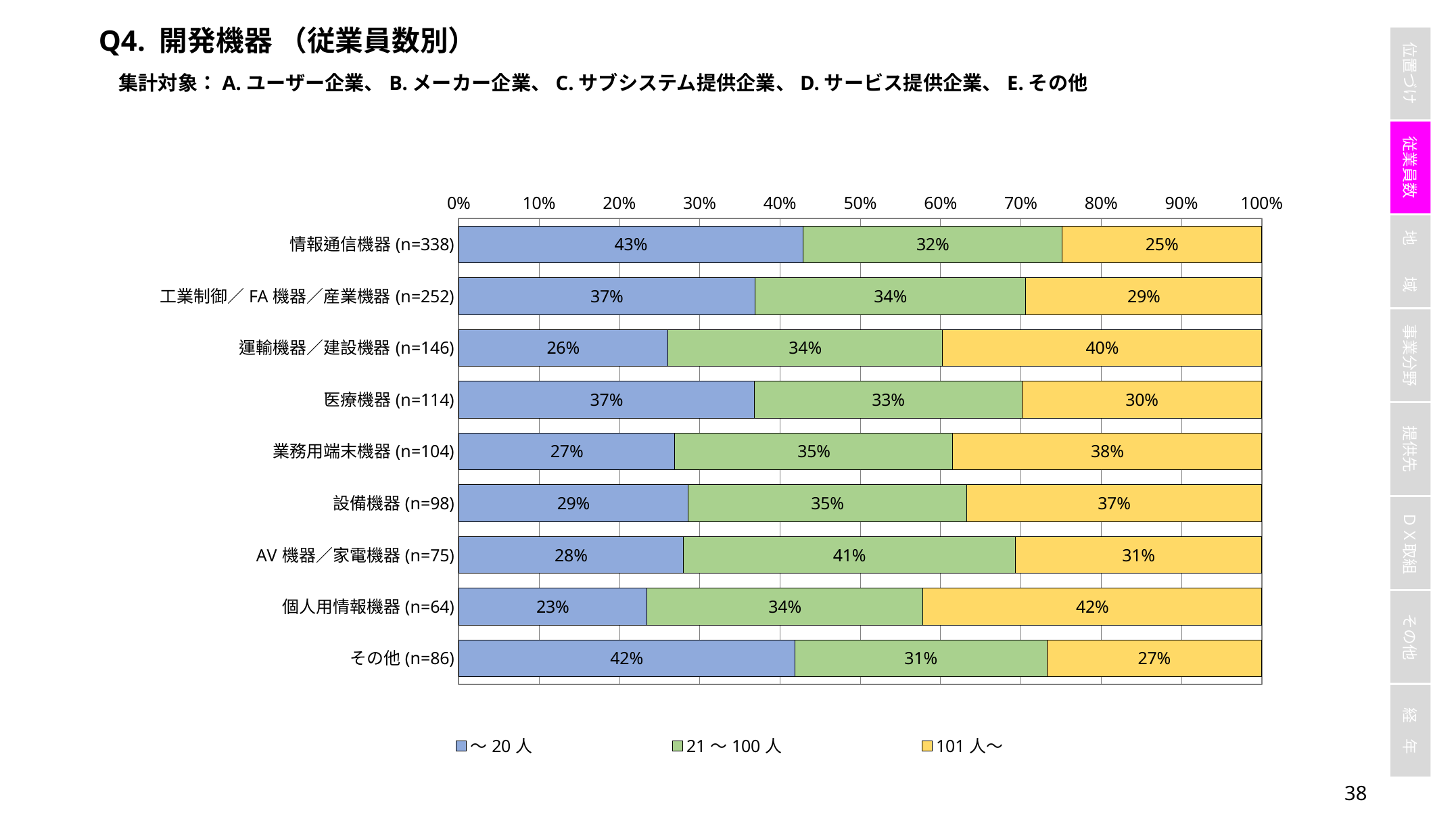
What kind of chart is shown on the slide? Stacked bar chart What is the difference between the 101人〜 values for 運輸機器／建設機器 (n=146) and 情報通信機器 (n=338)? 15% What is the value for 101人〜 in the 個人用情報機器 (n=64) bar? 42% How many series does the legend list? 3 How many categories are shown on the y axis of the chart? 9 Which category has the highest 〜20人 value? 情報通信機器 (n=338) What is the 21〜100人 share for AV機器／家電機器 (n=75)? 41% What percentage of 情報通信機器 (n=338) respondents are in the 〜20人 category? 43% Which category has the highest 101人〜 value? 個人用情報機器 (n=64) Which is larger: the 〜20人 value for 医療機器 (n=114) or for 設備機器 (n=98)? 医療機器 (n=114) Which colour represents the 21〜100人 series in the chart? Green Which category has the lowest 〜20人 value? 個人用情報機器 (n=64)